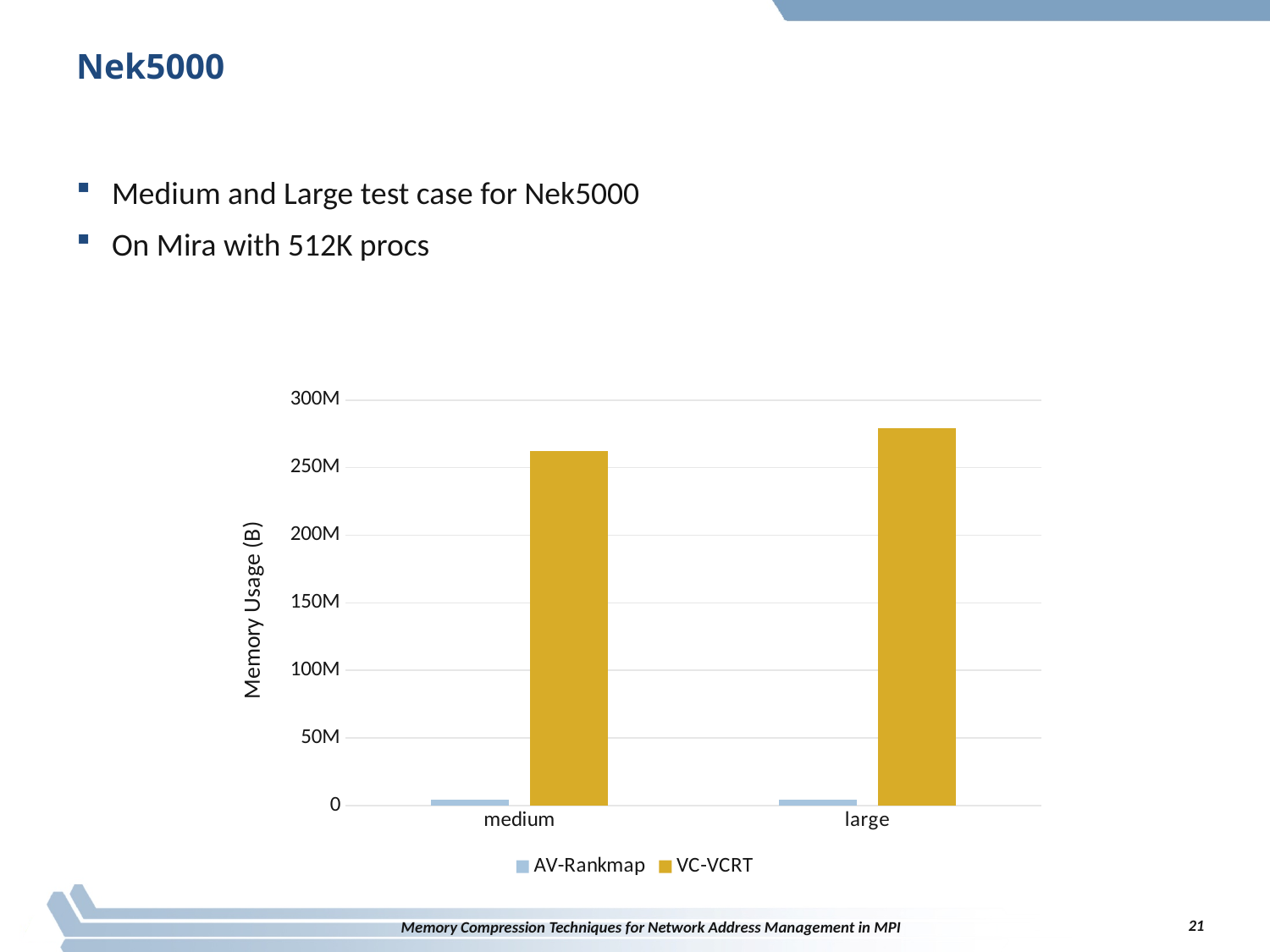
How many categories are shown on the x axis? 2 What kind of chart is shown on the slide? bar chart Is the VC-VCRT value for large greater or less than 300M? less Which series has the higher memory usage for the large test case? VC-VCRT Is the AV-Rankmap value for large greater or less than 50M? less How many series does the legend list? 2 Is the VC-VCRT value for medium greater or less than 250M? greater Does the VC-VCRT memory usage rise or fall from medium to large? rise Which series is listed first in the legend? AV-Rankmap What is the label of the y axis? Memory Usage (B) For VC-VCRT, which test case has the higher memory usage, medium or large? large